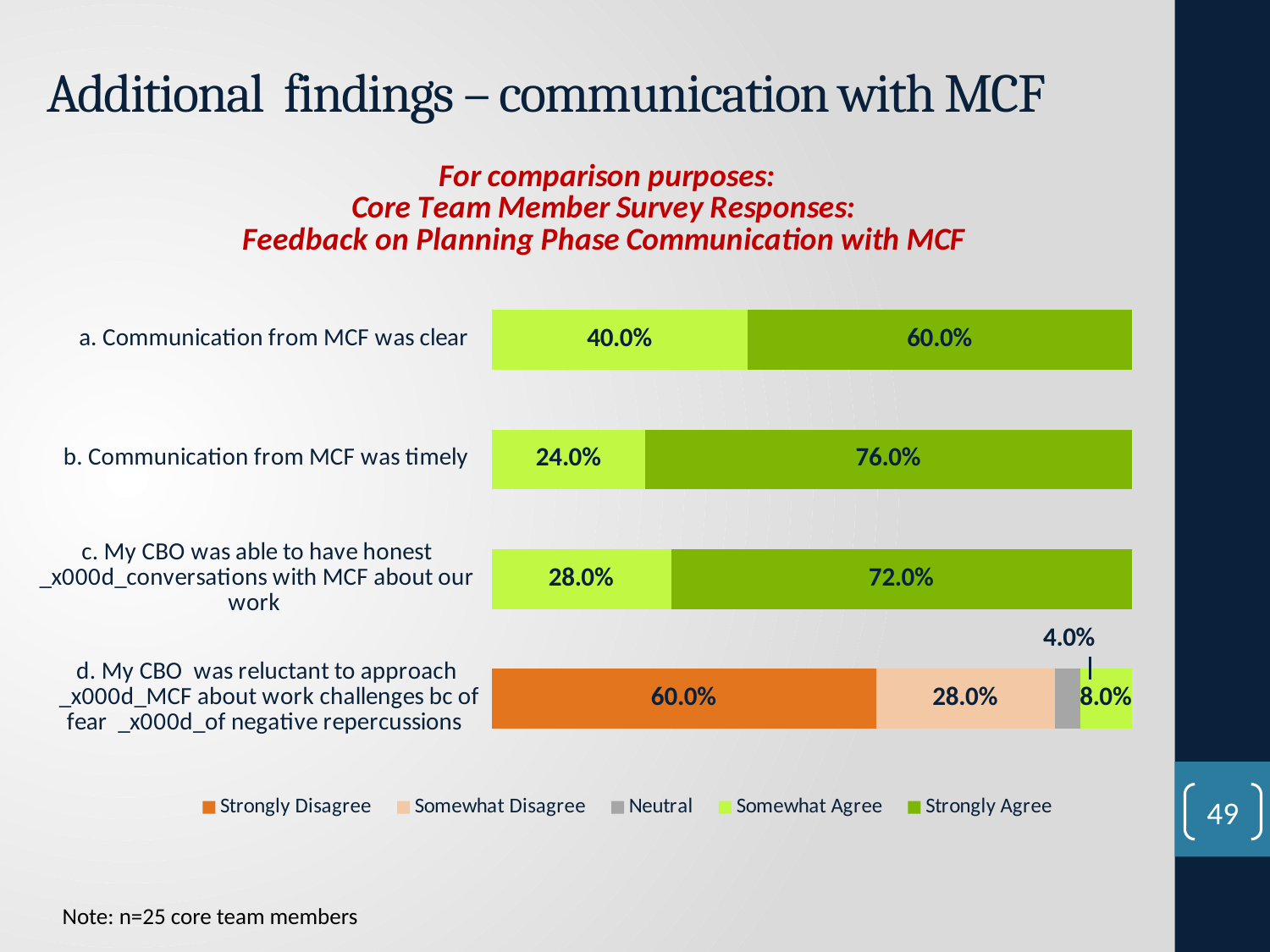
Which statement has the lowest Somewhat Agree percentage? d. My CBO was reluctant to approach MCF about work challenges bc of fear of negative repercussions How many statements (categories) are shown in the chart? 4 What percentage of core team members strongly agreed that communication from MCF was clear? 60.0% What is the difference between the Strongly Agree and Somewhat Agree percentages for 'Communication from MCF was clear'? 20.0% What is the Neutral value for the statement that the CBO was reluctant to approach MCF about work challenges? 4.0% What is the Strongly Disagree value for the statement that the CBO was reluctant to approach MCF about work challenges? 60.0% Is the Strongly Agree percentage larger for 'Communication from MCF was timely' or for 'My CBO was able to have honest conversations with MCF about our work'? b. Communication from MCF was timely Which statement has the highest Strongly Agree percentage? b. Communication from MCF was timely How many response categories does the legend list? 5 What percentage of core team members somewhat agreed that communication from MCF was timely? 24.0% What is the combined percentage of Strongly Disagree and Somewhat Disagree for the statement about being reluctant to approach MCF? 88.0% What type of chart is shown on the slide? Stacked bar chart